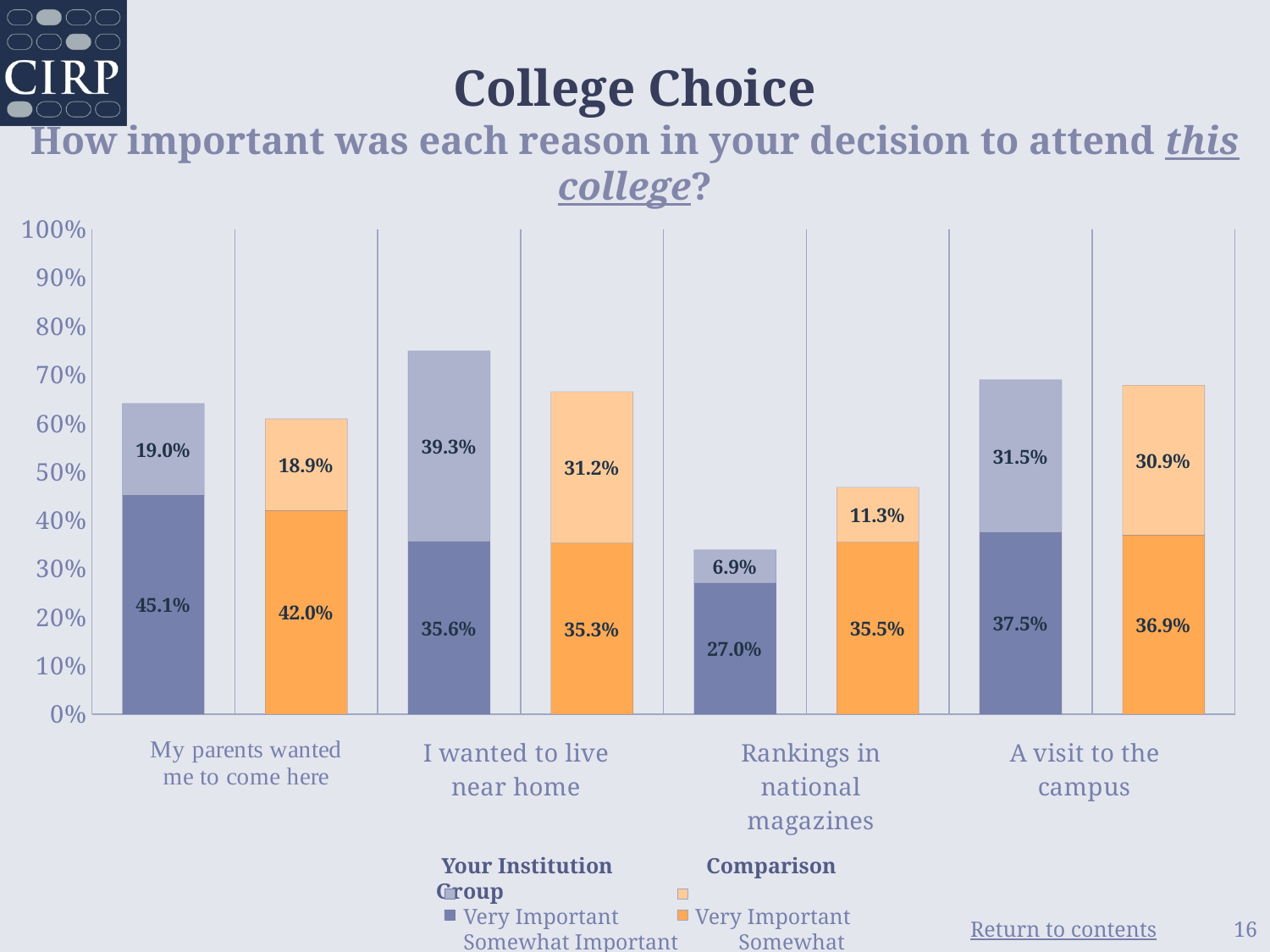
Which reason has the highest Very Important percentage for the Comparison Group? My parents wanted me to come here How many series does the chart legend list? 4 What is the combined Very Important and Somewhat Important percentage for the Comparison Group for "Rankings in national magazines"? 46.8% What percentage of Your Institution students rated "A visit to the campus" as Very Important? 37.5% For "I wanted to live near home", which group has the larger Somewhat Important percentage, Your Institution or the Comparison Group? Your Institution What is the difference between the Your Institution and Comparison Group Very Important percentages for "Rankings in national magazines"? 8.5% What percentage of Your Institution students rated "My parents wanted me to come here" as Very Important? 45.1% Which reason has the lowest Very Important percentage for Your Institution? Rankings in national magazines What type of chart is shown on the slide? Stacked bar chart How many reasons (categories) are shown on the x axis of the chart? 4 What is the combined Very Important and Somewhat Important percentage for Your Institution for "I wanted to live near home"? 74.9% What percentage of the Comparison Group rated "Rankings in national magazines" as Somewhat Important? 11.3%